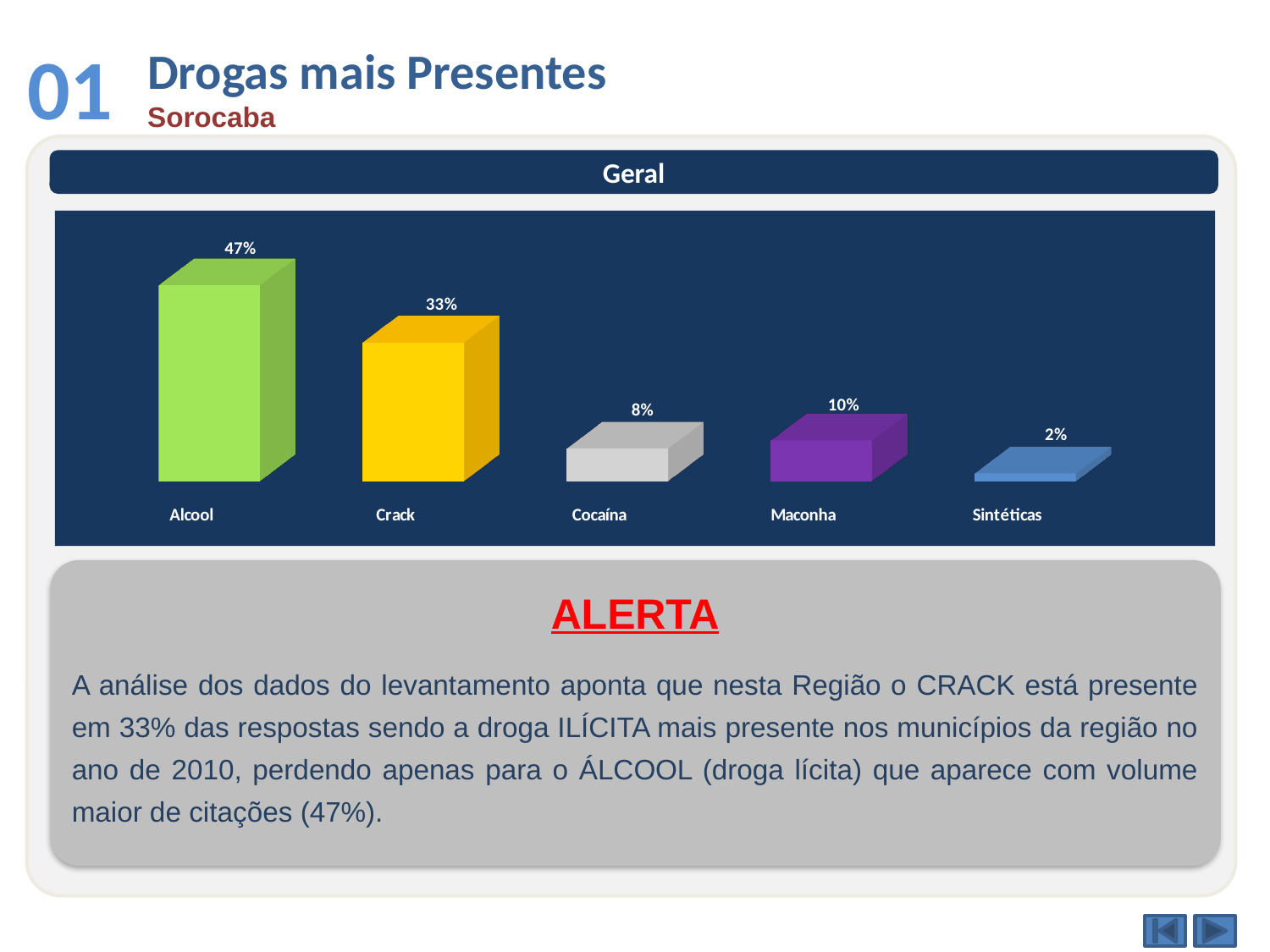
What is the value for Sintéticas? 2% What is the value for Alcool? 47% What is the difference between the values for Alcool and Crack? 14% What is the value for Crack? 33% What kind of chart is shown on the slide? Bar chart Which category has the highest value? Alcool What is the value for Cocaína? 8% What is the title shown above the chart? Geral What is the value for Maconha? 10% Which category has the lowest value? Sintéticas How many categories are shown in the chart? 5 Which is larger, the value for Maconha or the value for Cocaína? Maconha